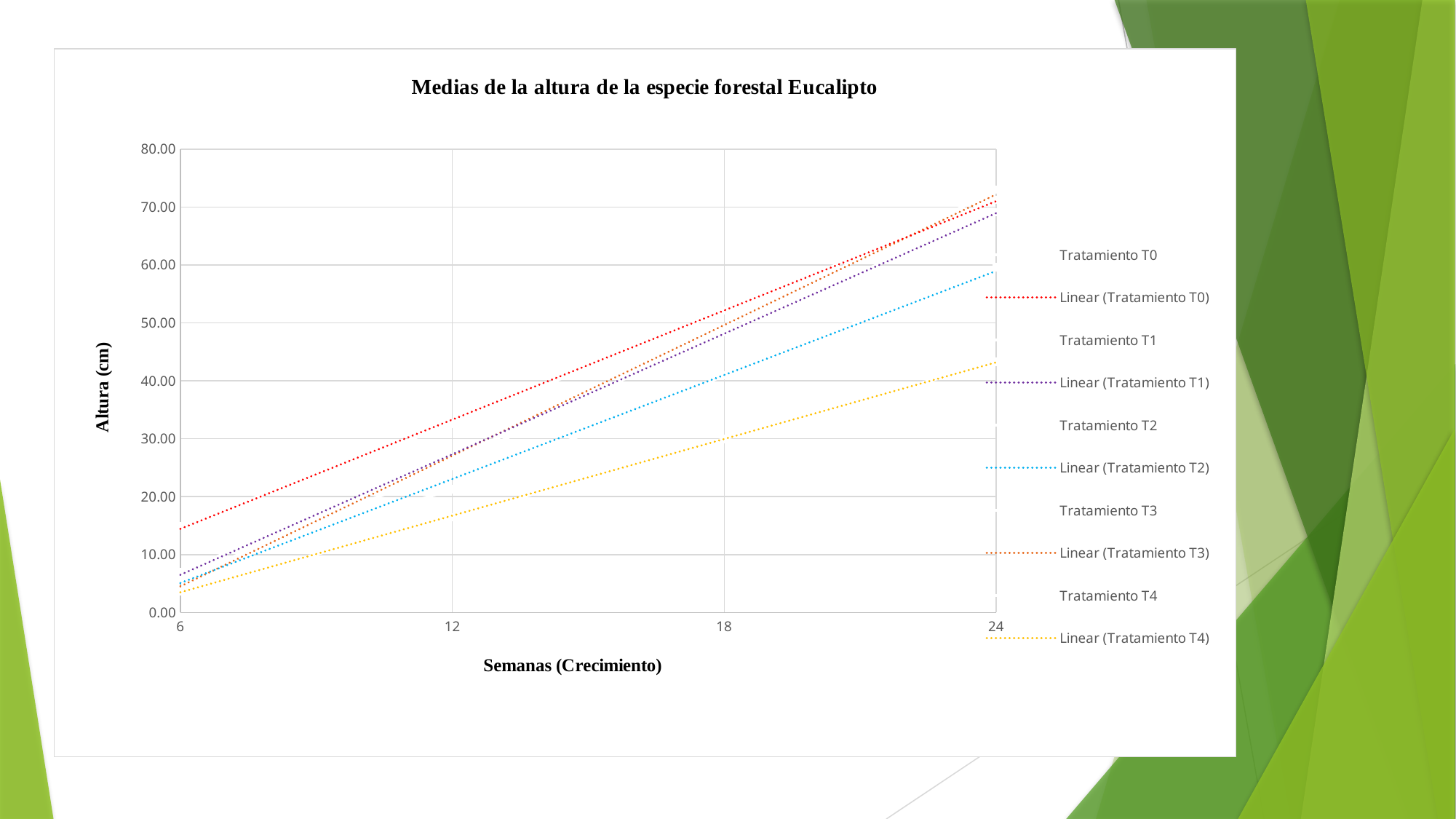
Do the trendlines rise or fall as the weeks increase from 6 to 24? rise How many week values are marked on the x axis? 4 Is the value of the Linear (Tratamiento T2) line at week 24 greater or less than 50.00? greater What is the label of the y axis? Altura (cm) What kind of chart is shown on the slide? line chart At week 24, which is larger: the Linear (Tratamiento T2) line or the Linear (Tratamiento T4) line? Linear (Tratamiento T2) Which treatment's linear trendline is lowest at week 24? Tratamiento T4 What is the title of the chart? Medias de la altura de la especie forestal Eucalipto Which treatment's linear trendline is highest at week 6? Tratamiento T0 Is the value of the Linear (Tratamiento T0) line at week 6 greater or less than 10.00? greater Is the value of the Linear (Tratamiento T4) line at week 24 greater or less than 40.00? greater How many entries does the chart legend list? 10